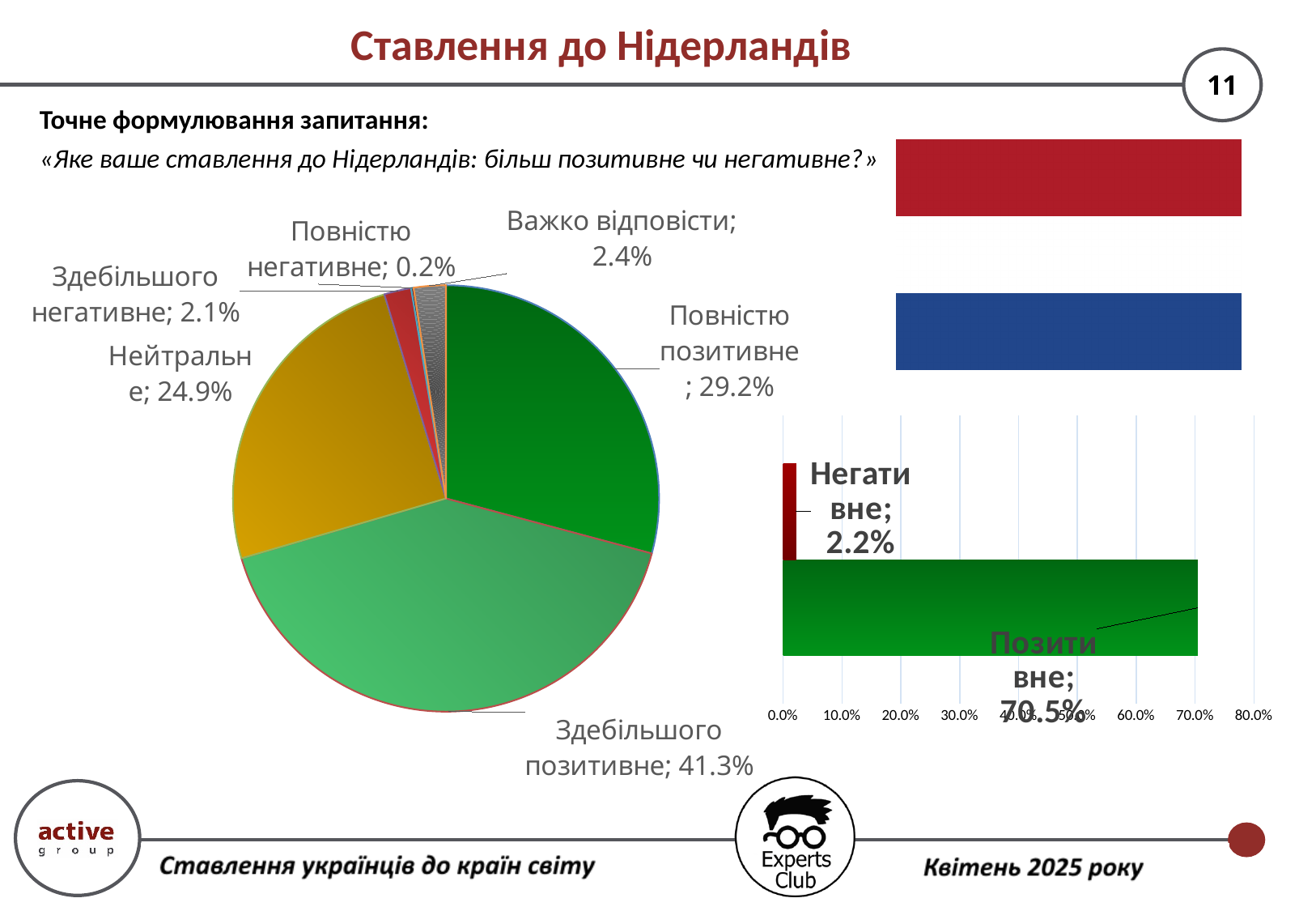
In the pie chart on the left, which is larger: "Важко відповісти" or "Здебільшого негативне"? Важко відповісти What kind of chart is shown on the left of the slide? Pie chart In the pie chart on the left, which category has the largest slice? Здебільшого позитивне In the bar chart on the right, what is the value for "Позитивне"? 70.5% In the bar chart on the right, what is the difference between "Позитивне" and "Негативне"? 68.3% In the pie chart on the left, what is the difference between "Здебільшого позитивне" and "Повністю позитивне"? 12.1% In the pie chart on the left, what share is labelled for "Повністю негативне"? 0.2% In the pie chart on the left, what share is labelled for "Нейтральне"? 24.9% How many slices does the pie chart on the left have? 6 In the bar chart on the right, what is the value for "Негативне"? 2.2% In the pie chart on the left, which category has the smallest slice? Повністю негативне In the pie chart on the left, what share is labelled for "Здебільшого позитивне"? 41.3%